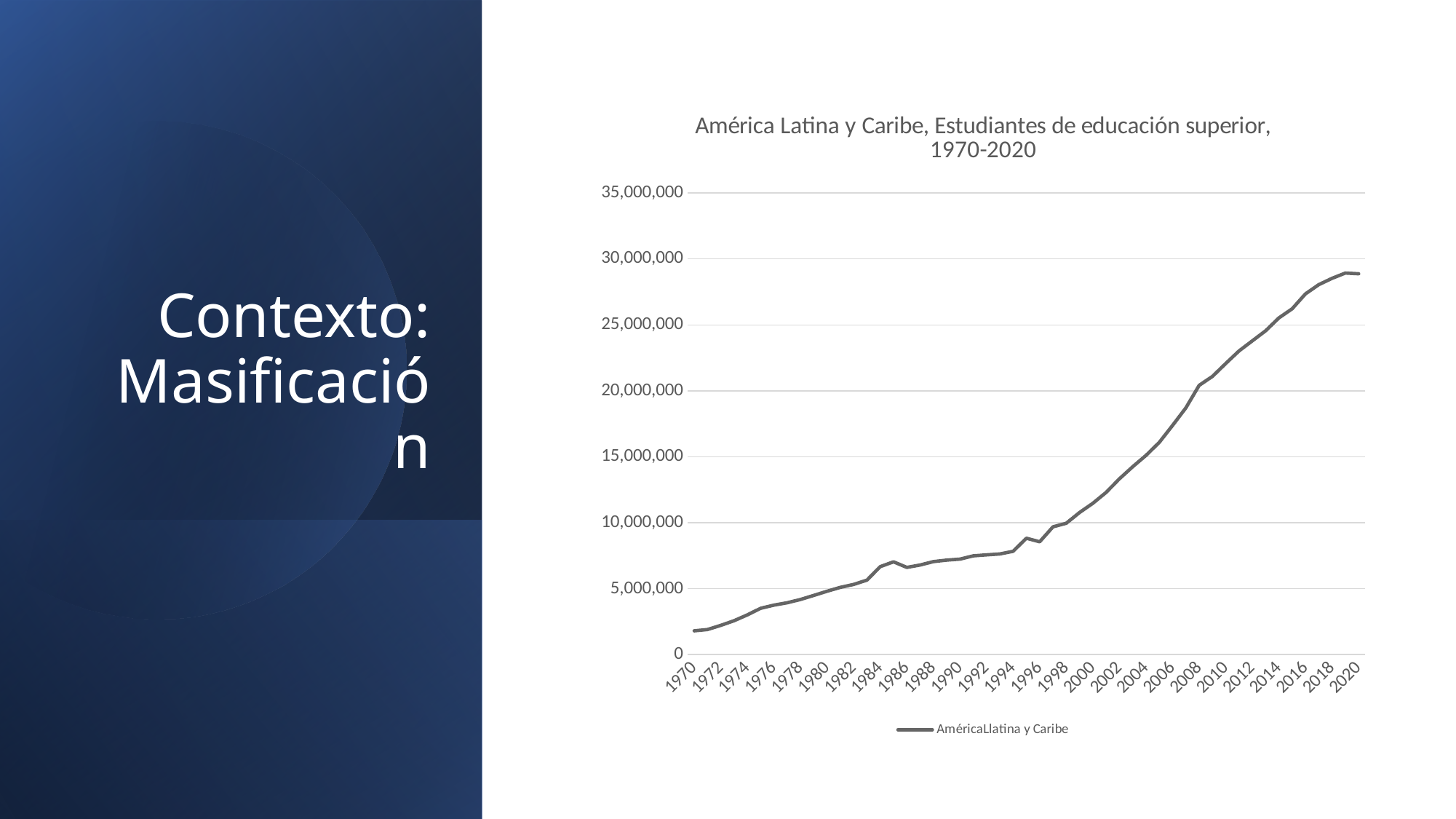
Is the value for 2020 greater or less than 30,000,000? less Which year has the lowest value on the chart? 1970 Is the value for 2000 greater or less than 10,000,000? greater What is the name of the series shown in the legend? AméricaLlatina y Caribe What kind of chart is shown on the slide? line chart Do the values generally rise or fall from 1970 to 2020? rise Is the value for 1990 greater or less than 10,000,000? less Which is larger, the value for 2010 or the value for 1990? 2010 What is the title of the chart? América Latina y Caribe, Estudiantes de educación superior, 1970-2020 How many series does the legend list? 1